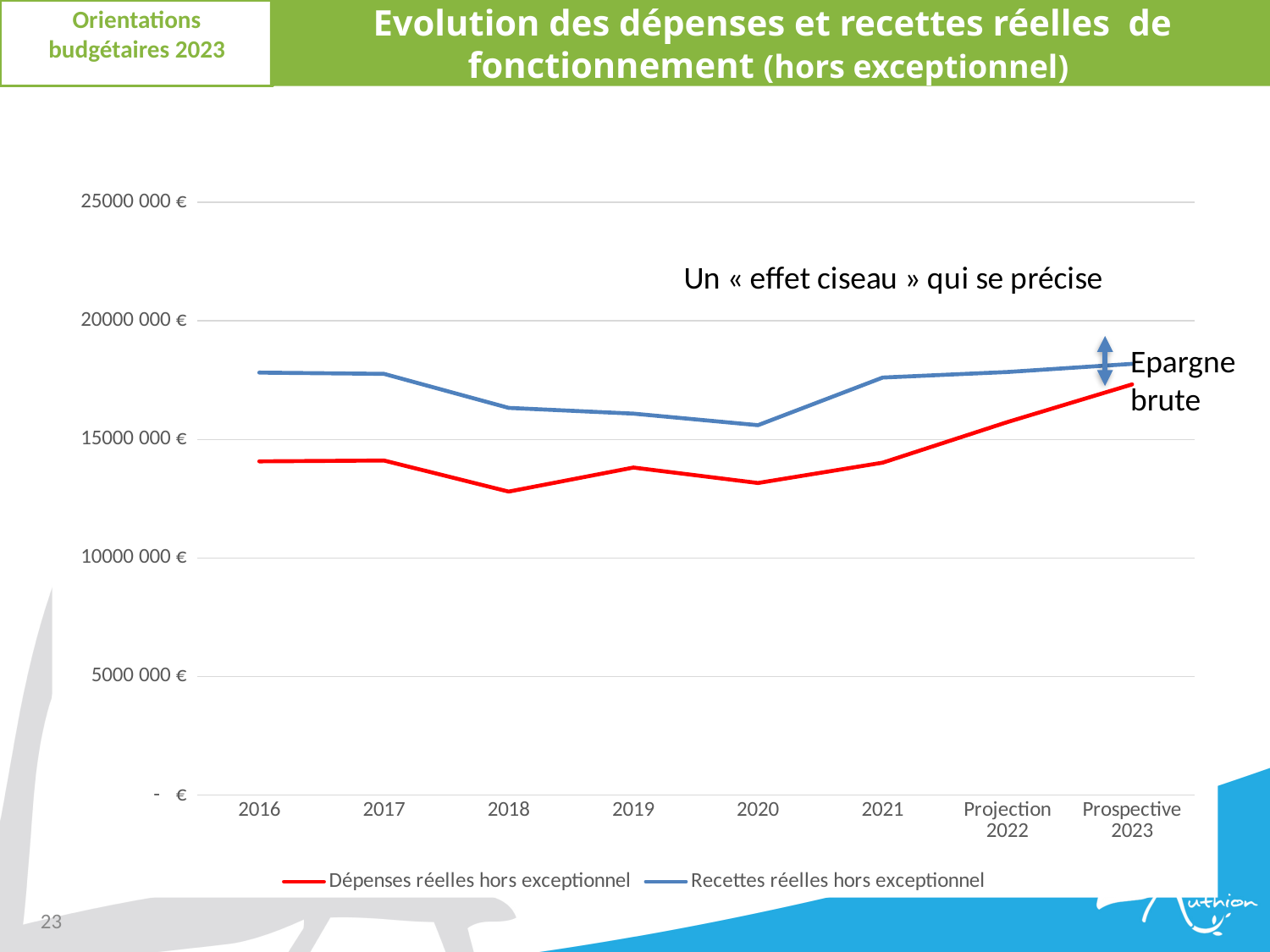
Is the value for Dépenses réelles hors exceptionnel in 2018 greater or less than 15000 000 €? less In which year is the value for Dépenses réelles hors exceptionnel lowest? 2018 Is the value for Recettes réelles hors exceptionnel in 2016 greater or less than 15000 000 €? greater How many points are plotted along the x axis for each series? 8 Is the value for Recettes réelles hors exceptionnel in 2017 greater or less than 20000 000 €? less In 2020, which series has the larger value: Dépenses réelles hors exceptionnel or Recettes réelles hors exceptionnel? Recettes réelles hors exceptionnel What colour is the line for Dépenses réelles hors exceptionnel? Red Do the values for Dépenses réelles hors exceptionnel rise or fall from 2020 to Prospective 2023? Rise In which year is the value for Recettes réelles hors exceptionnel lowest? 2020 How many series does the legend list? 2 At which x-axis point is the value for Dépenses réelles hors exceptionnel highest? Prospective 2023 What kind of chart is shown on the slide? Line chart